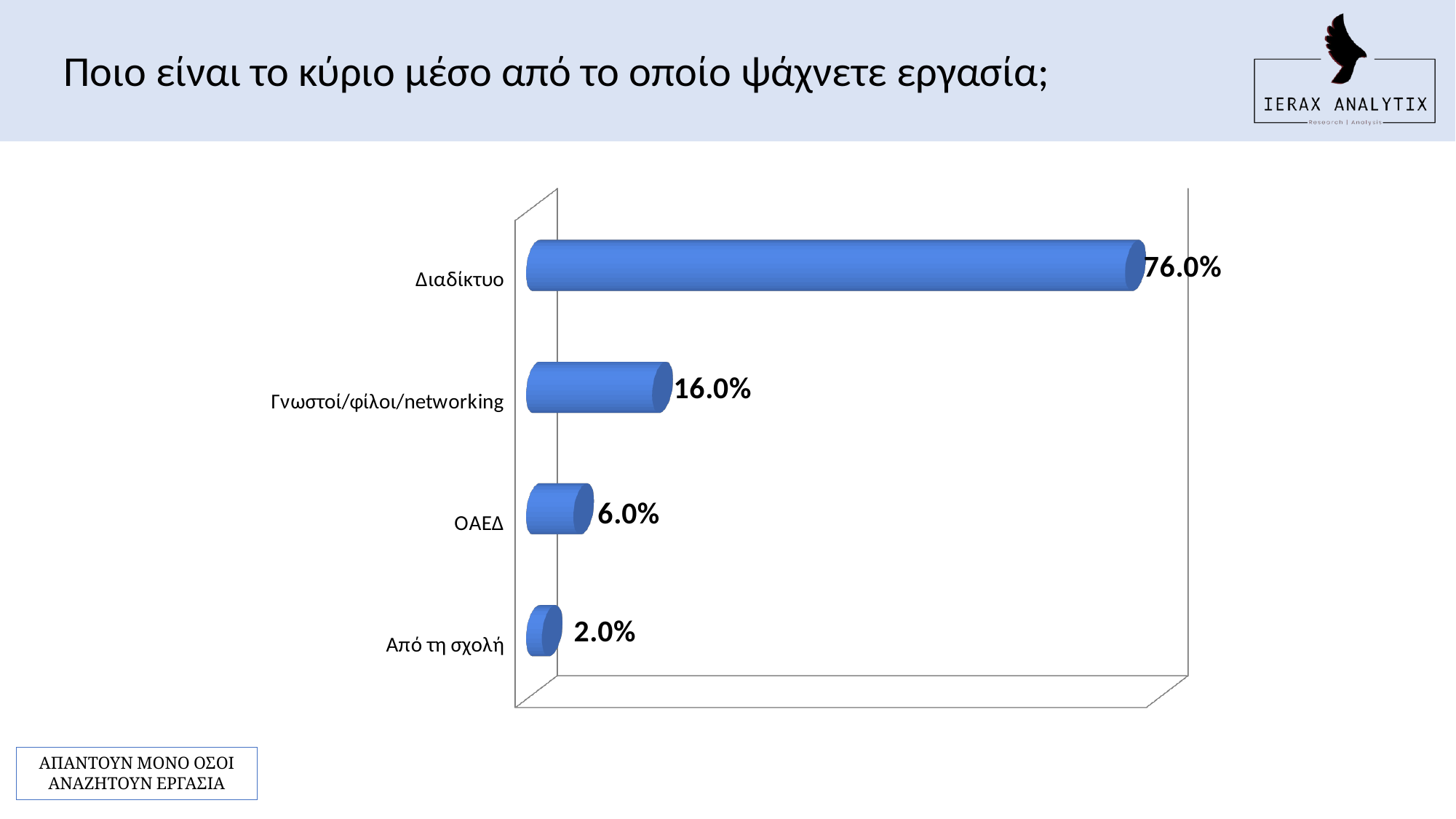
What is the title of the slide above the chart? Ποιο είναι το κύριο μέσο από το οποίο ψάχνετε εργασία; What is the difference between the values for ΟΑΕΔ and Από τη σχολή? 4.0% How many categories are shown in the chart? 4 What is the difference between the values for Διαδίκτυο and Γνωστοί/φίλοι/networking? 60.0% Which category has the lowest value? Από τη σχολή Which category has the highest value? Διαδίκτυο What kind of chart is shown on the slide? Bar chart What percentage is shown for Γνωστοί/φίλοι/networking? 16.0% What percentage is shown for ΟΑΕΔ? 6.0% What percentage is shown for Από τη σχολή? 2.0% What percentage is shown for Διαδίκτυο? 76.0% Which is larger, the value for Γνωστοί/φίλοι/networking or the value for ΟΑΕΔ? Γνωστοί/φίλοι/networking